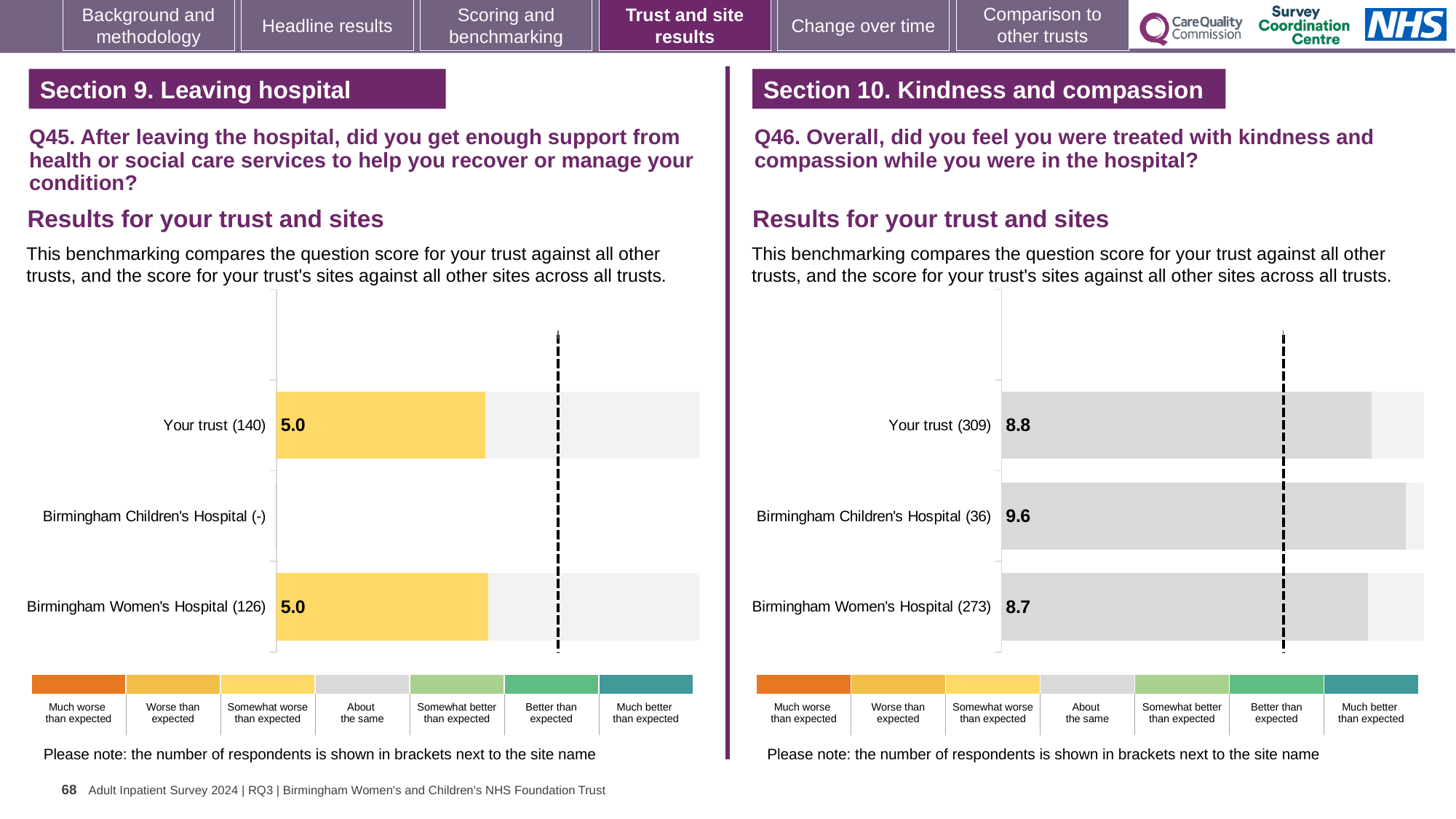
In the Q45 chart on the left, what is the score for Your trust? 5.0 How many respondents are shown in brackets for Your trust in the Q45 chart on the left? 140 In the Q46 chart on the right, what is the score for Your trust? 8.8 How many respondents are shown in brackets for Birmingham Women's Hospital in the Q46 chart on the right? 273 What kind of chart is used in the Q45 chart on the left? Bar chart In the Q46 chart on the right, what is the score for Birmingham Women's Hospital? 8.7 In the Q46 chart on the right, what is the score for Birmingham Children's Hospital? 9.6 In the Q46 chart on the right, what is the difference between the scores for Birmingham Children's Hospital and Birmingham Women's Hospital? 0.9 In the Q45 chart on the left, which benchmark category does the colour of the bars correspond to according to the legend? Somewhat worse than expected In the Q45 chart on the left, what is the score for Birmingham Women's Hospital? 5.0 In the Q46 chart on the right, which has the larger score, Your trust or Birmingham Children's Hospital? Birmingham Children's Hospital In the Q46 chart on the right, which site or trust has the highest score? Birmingham Children's Hospital